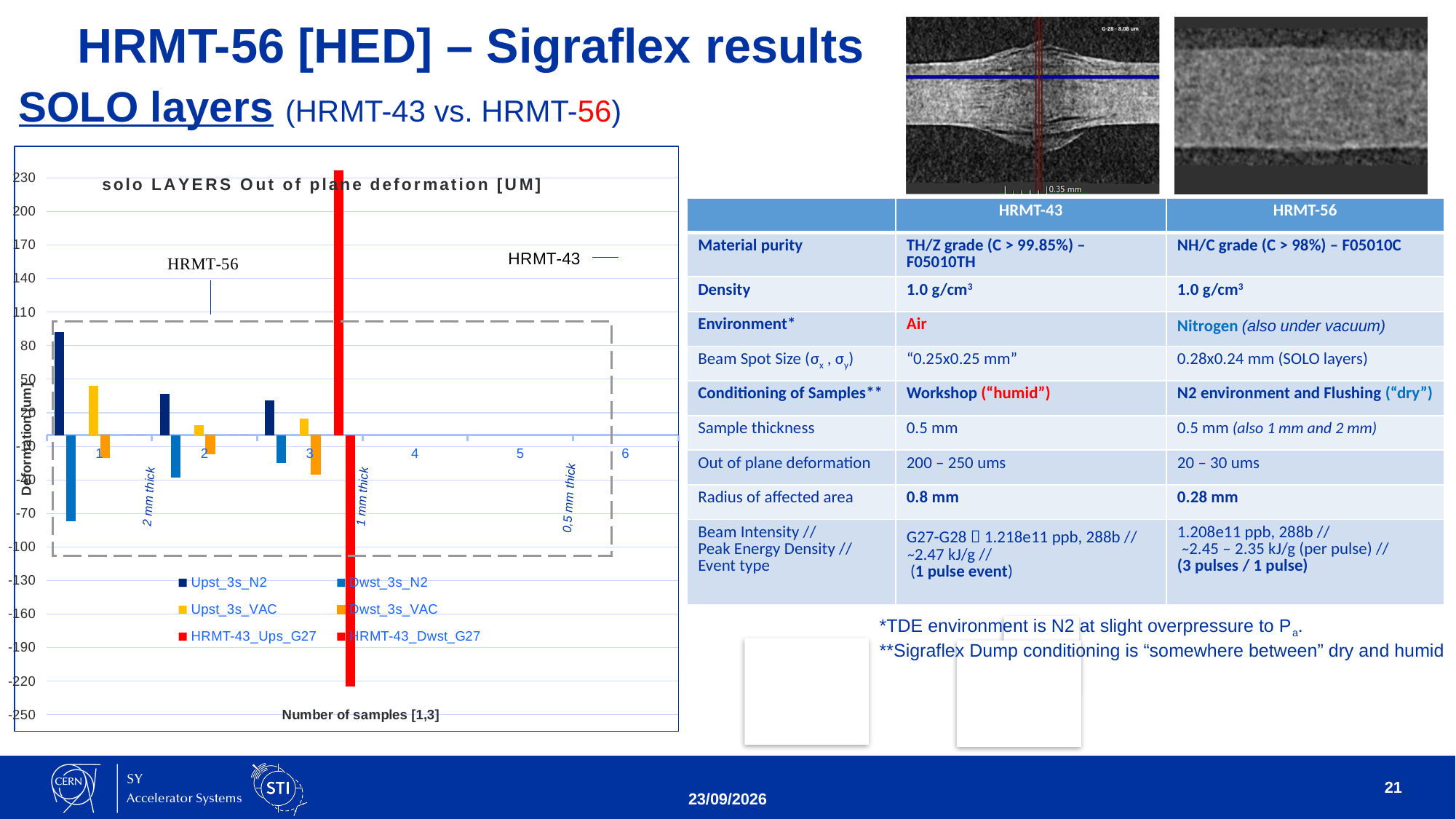
Is the value of the Dwst_3s_N2 bar at sample 1 greater or less than -40? less Is the value of the HRMT-43_Ups_G27 bar greater or less than 200? greater What is the title of the chart? solo LAYERS Out of plane deformation [UM] What kind of chart is shown on the slide? bar chart How many series does the chart legend list? 6 Which series has the lowest (most negative) bar in the chart? HRMT-43_Dwst_G27 Which series has the tallest positive bar in the chart? HRMT-43_Ups_G27 Which is larger, the HRMT-43_Ups_G27 bar or the Upst_3s_N2 bar at sample 3? HRMT-43_Ups_G27 Is the value of the HRMT-43_Dwst_G27 bar greater or less than -190? less What is the x-axis title of the chart? Number of samples [1,3] Which is larger, the Upst_3s_N2 bar at sample 1 or the Upst_3s_VAC bar at sample 1? Upst_3s_N2